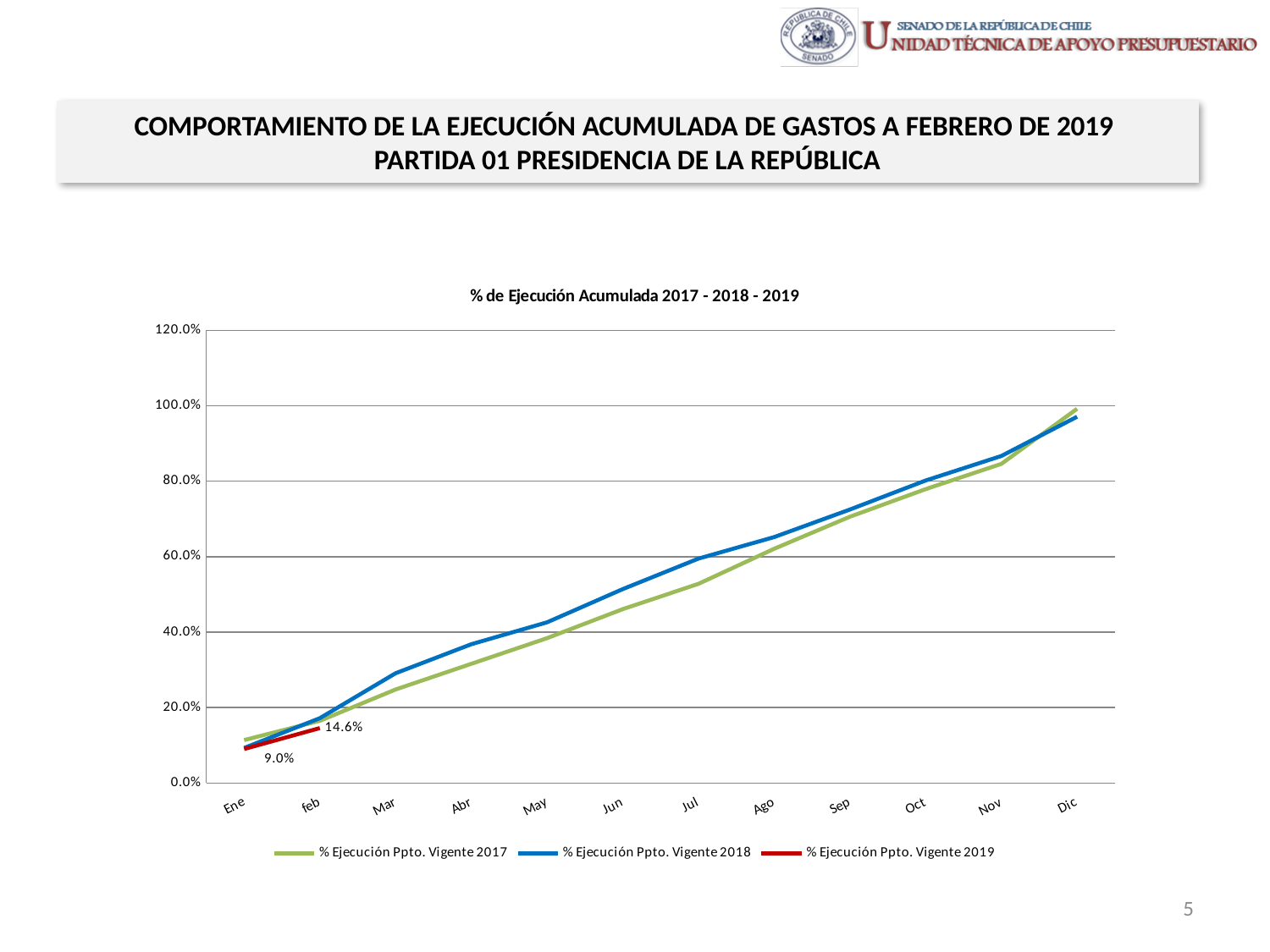
Do the values for % Ejecución Ppto. Vigente 2018 rise or fall from Ene to Dic? Rise How many series does the legend list? 3 Is the value for % Ejecución Ppto. Vigente 2018 in Dic greater or less than 80.0%? greater What is the value of % Ejecución Ppto. Vigente 2019 for Ene? 9.0% What is the title of the chart? % de Ejecución Acumulada 2017 - 2018 - 2019 In Jul, which series has the higher value: % Ejecución Ppto. Vigente 2017 or % Ejecución Ppto. Vigente 2018? % Ejecución Ppto. Vigente 2018 What colour is the line for % Ejecución Ppto. Vigente 2019? Red How many months are shown on the x axis? 12 What kind of chart is shown on the slide? Line chart What is the value of % Ejecución Ppto. Vigente 2019 for feb? 14.6% Is the value for % Ejecución Ppto. Vigente 2017 in Ene greater or less than 20.0%? less By how much did % Ejecución Ppto. Vigente 2019 increase from Ene to feb? 5.6%